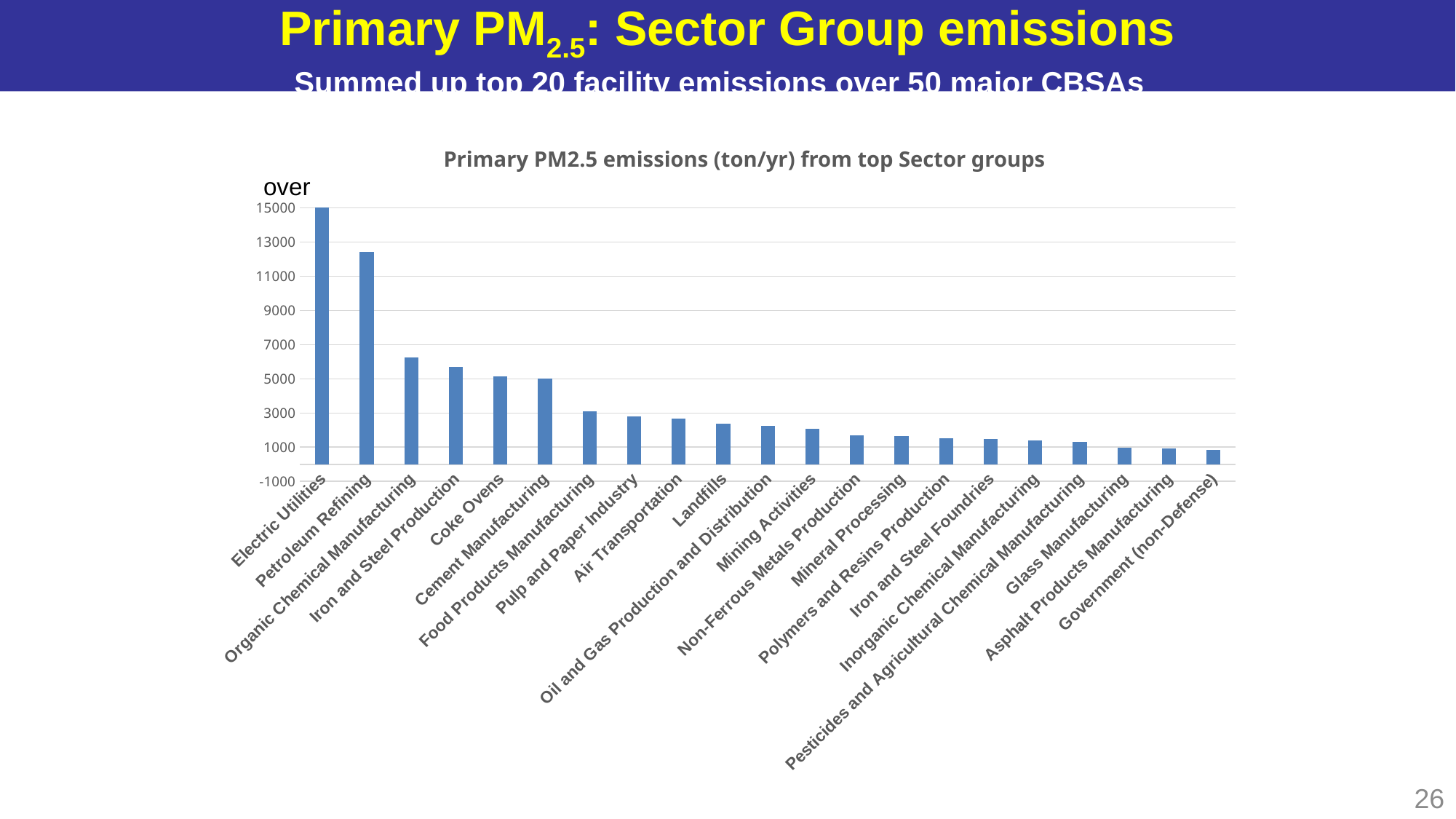
Do the bar values rise or fall moving from left to right along the x axis? fall Is the value for Electric Utilities greater or less than 13000? greater Which sector group has the highest primary PM2.5 emissions? Electric Utilities Is the value for Organic Chemical Manufacturing greater or less than 5000? greater Which has higher emissions, Iron and Steel Production or Landfills? Iron and Steel Production Which has higher emissions, Petroleum Refining or Organic Chemical Manufacturing? Petroleum Refining Is the value for Petroleum Refining greater or less than 11000? greater What kind of chart is shown on the slide? bar chart What is the title of the chart? Primary PM2.5 emissions (ton/yr) from top Sector groups How many sector groups are plotted in the chart? 21 Which sector group has the lowest primary PM2.5 emissions? Government (non-Defense)